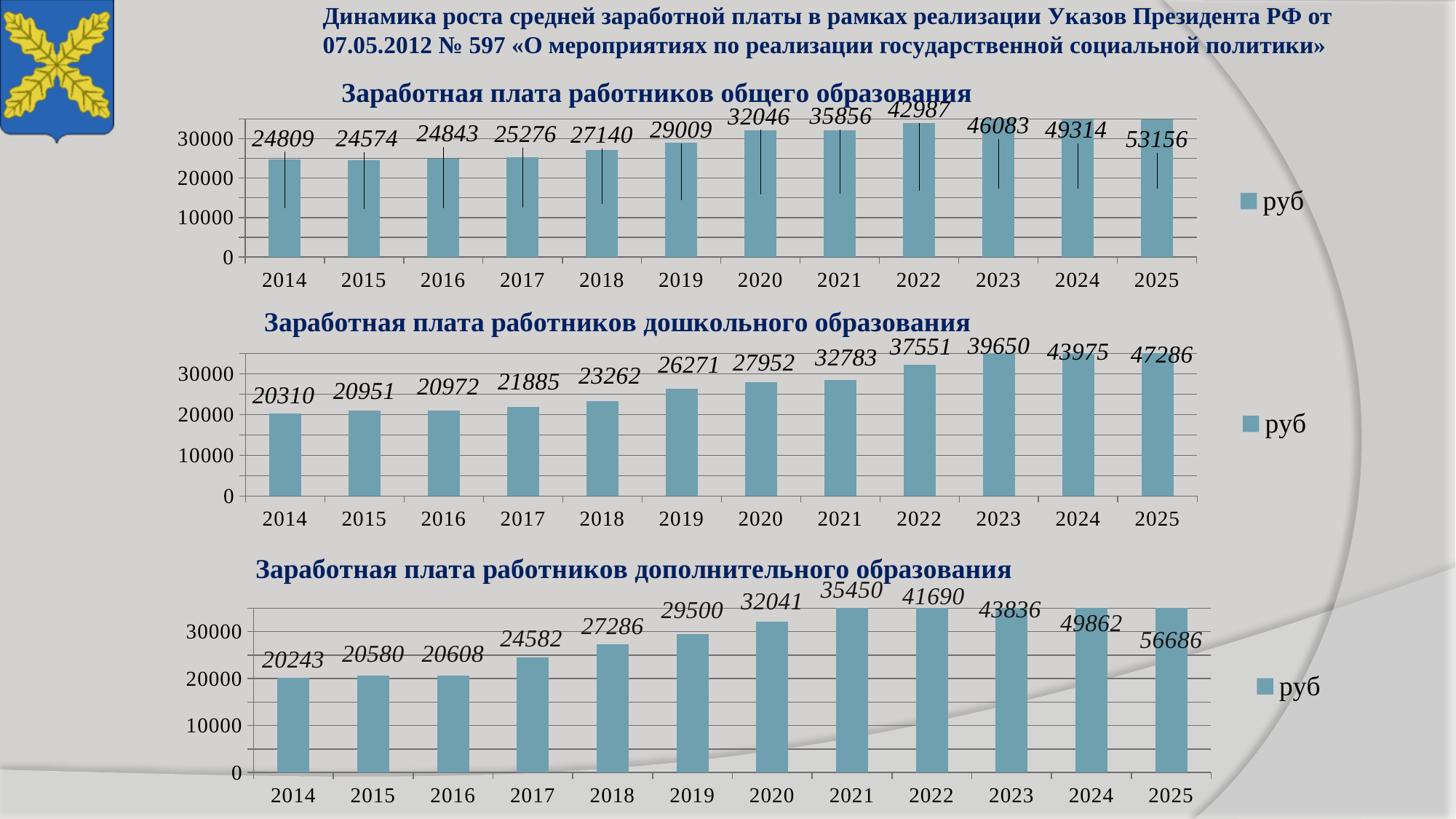
In the chart 'Заработная плата работников общего образования', which year has the lowest value? 2015 In the chart 'Заработная плата работников дополнительного образования', which is larger, the value for 2015 or the value for 2016? 2016 In the chart 'Заработная плата работников дополнительного образования', what is the value for 2017? 24582 In the chart 'Заработная плата работников дошкольного образования', which year has the highest value? 2025 In the chart 'Заработная плата работников общего образования', what is the value for 2020? 32046 How many years are shown on the x axis of the chart 'Заработная плата работников общего образования'? 12 In the chart 'Заработная плата работников дополнительного образования', what is the difference between the values for 2025 and 2024? 6824 In the chart 'Заработная плата работников дошкольного образования', what is the difference between the values for 2022 and 2021? 4768 In the chart 'Заработная плата работников дополнительного образования', do the values rise or fall from 2014 to 2025? rise In the chart 'Заработная плата работников дошкольного образования', what is the value for 2019? 26271 What kind of chart is 'Заработная плата работников дошкольного образования'? bar chart In the chart 'Заработная плата работников общего образования', what is the difference between the values for 2025 and 2014? 28347